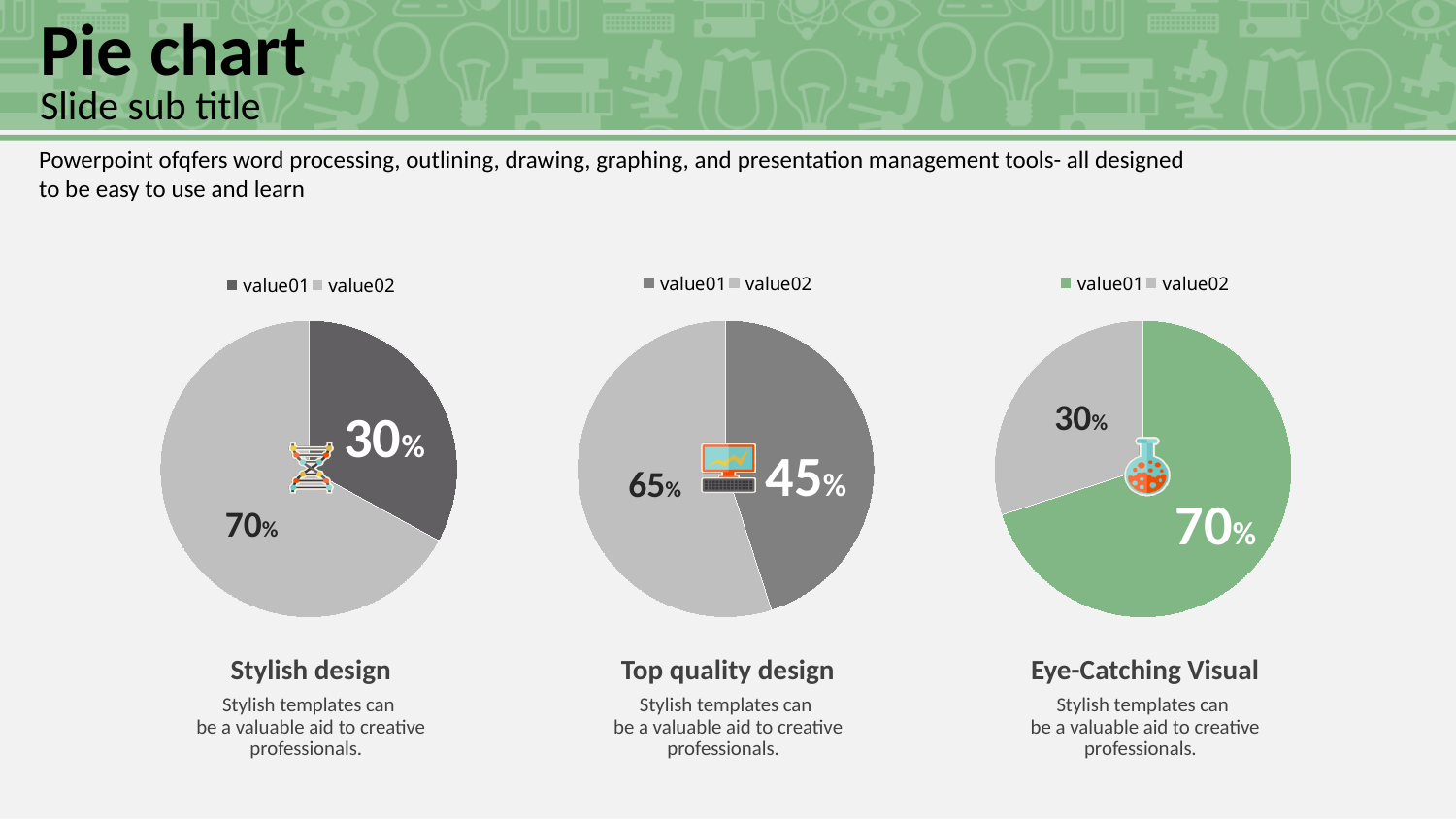
What kind of chart is the left chart on the slide? pie chart In the right pie chart, what is the value labelled for value01? 70% How many pie charts are shown on the slide? 3 In the right pie chart, what is the value labelled for value02? 30% In the right pie chart, which slice is the largest? value01 In the left pie chart, which slice is larger, value01 or value02? value02 In the middle pie chart, what is the value labelled for value02? 65% In the left pie chart, what is the value labelled for value02? 70% In the left pie chart, what is the difference between the value02 and value01 labels? 40% How many series does the legend of the middle pie chart list? 2 In the left pie chart, what is the value labelled for value01? 30% In the middle pie chart, what is the value labelled for value01? 45%